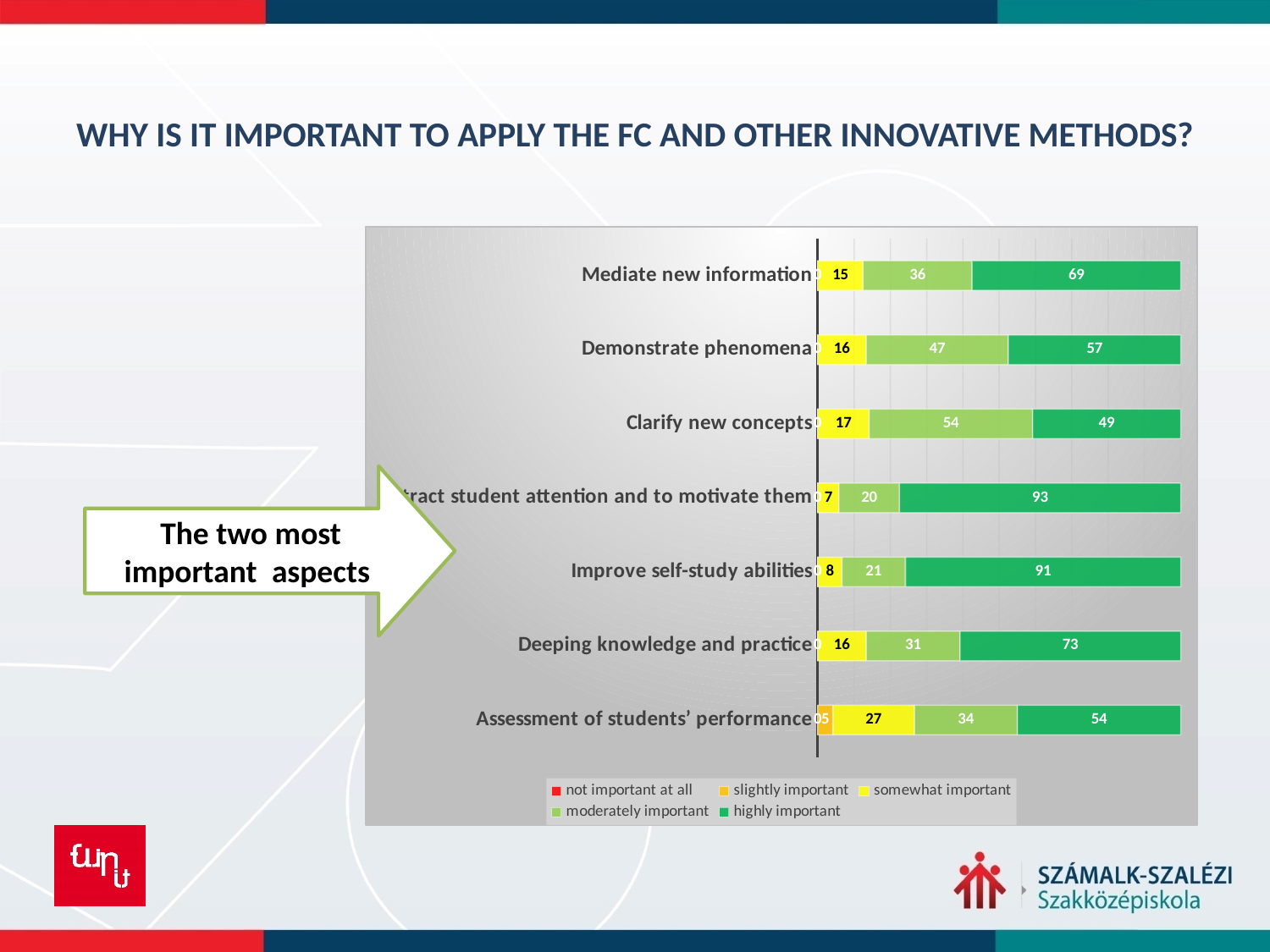
How many categories are shown in the chart? 7 What is the difference between the 'highly important' values for 'Mediate new information' and 'Demonstrate phenomena'? 12 What is the 'somewhat important' value for 'Improve self-study abilities'? 8 Which has the larger 'moderately important' value: 'Clarify new concepts' or 'Demonstrate phenomena'? Clarify new concepts What is the 'somewhat important' value for 'Assessment of students' performance'? 27 What kind of chart is shown on the slide? Stacked bar chart Which category has the highest 'moderately important' value? Clarify new concepts Which category has the lowest 'highly important' value? Clarify new concepts How many series does the legend list? 5 What is the 'moderately important' value for 'Clarify new concepts'? 54 What is the 'highly important' value for 'Mediate new information'? 69 What is the 'highly important' value for 'Deeping knowledge and practice'? 73